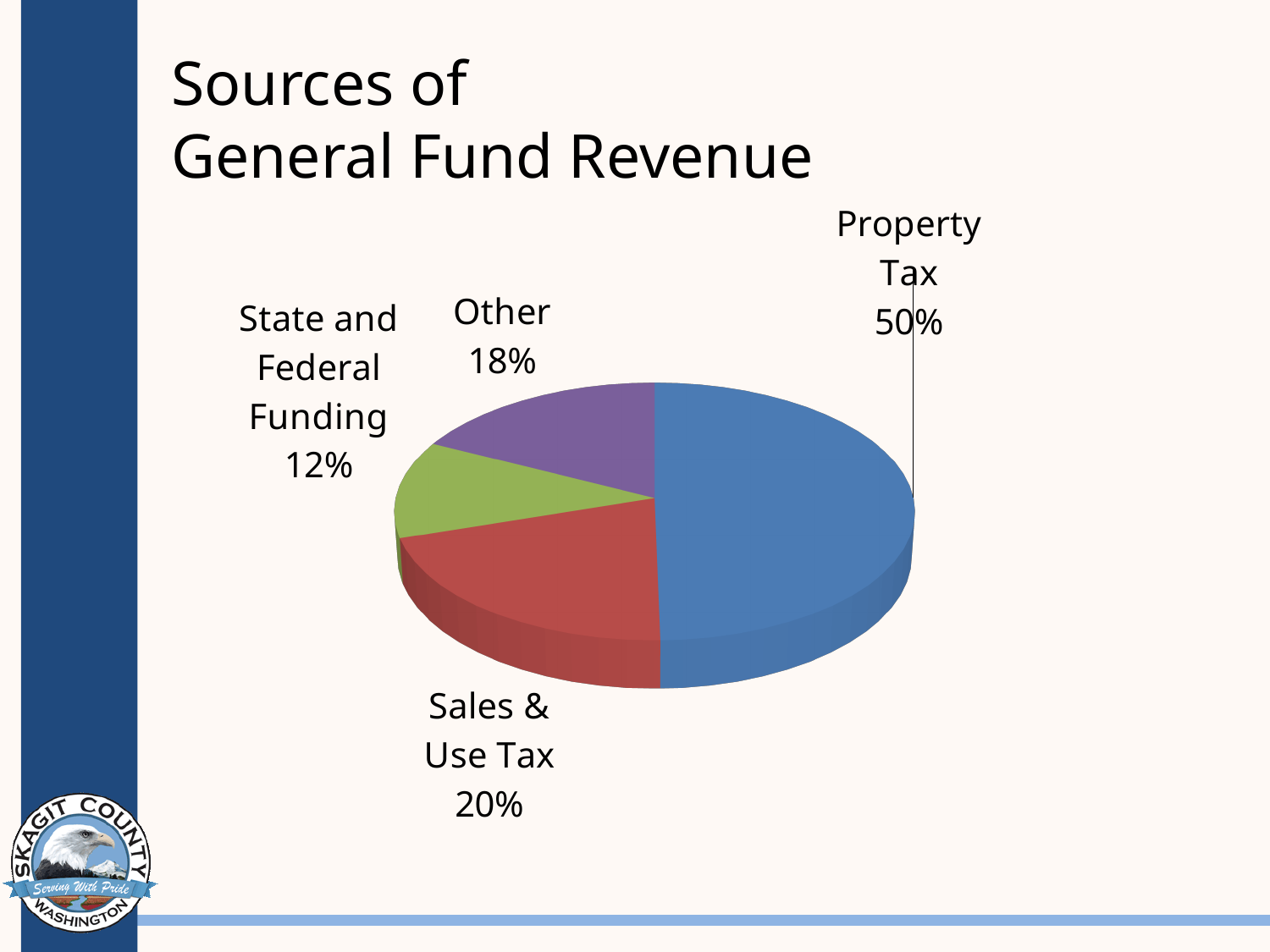
What share of General Fund Revenue comes from Sales & Use Tax? 20% What kind of chart is shown on the slide? Pie chart Which source makes up the largest share of General Fund Revenue? Property Tax How many percentage points larger is the Property Tax share than the Sales & Use Tax share? 30 What is the title of the slide containing the chart? Sources of General Fund Revenue How many sources of revenue are shown in the pie chart? 4 Which is larger, the share for Other or the share for Sales & Use Tax? Sales & Use Tax What share of General Fund Revenue comes from Other? 18% What share of General Fund Revenue comes from Property Tax? 50% How many percentage points larger is the Other share than the State and Federal Funding share? 6 Which source makes up the smallest share of General Fund Revenue? State and Federal Funding